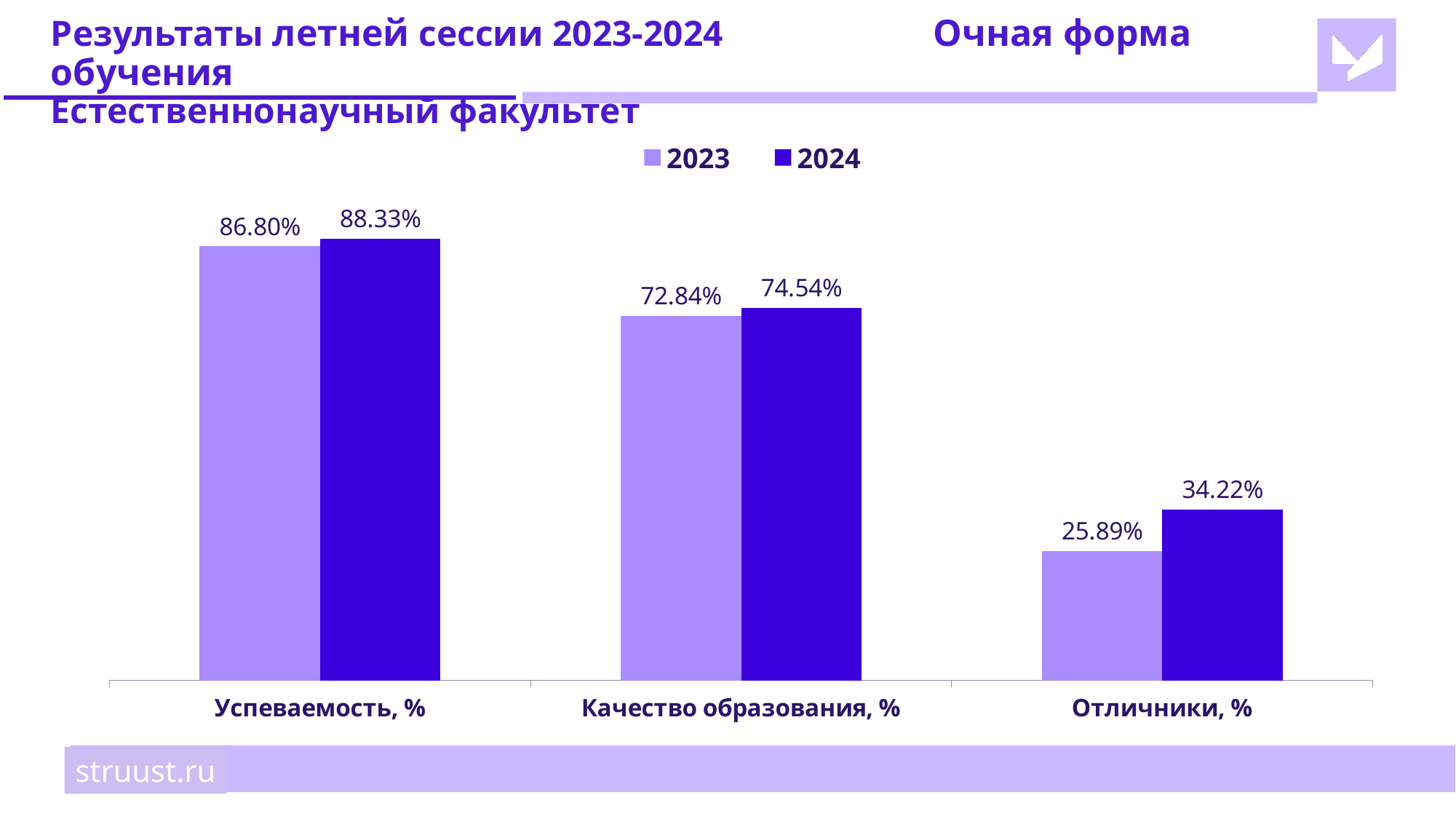
What is the 2024 value for Качество образования, %? 74.54% What is the 2023 value for Отличники, %? 25.89% How many categories are shown on the x axis? 3 What is the difference between the 2024 and 2023 values for Успеваемость, %? 1.53% Which category has the highest 2024 value? Успеваемость, % How many series does the legend list? 2 What kind of chart is shown on the slide? Bar chart What is the difference between the 2024 and 2023 values for Отличники, %? 8.33% Which category has the lowest 2023 value? Отличники, % Which is larger for Качество образования, %: the 2023 value or the 2024 value? 2024 What is the 2024 value for Отличники, %? 34.22% What is the 2023 value for Успеваемость, %? 86.80%